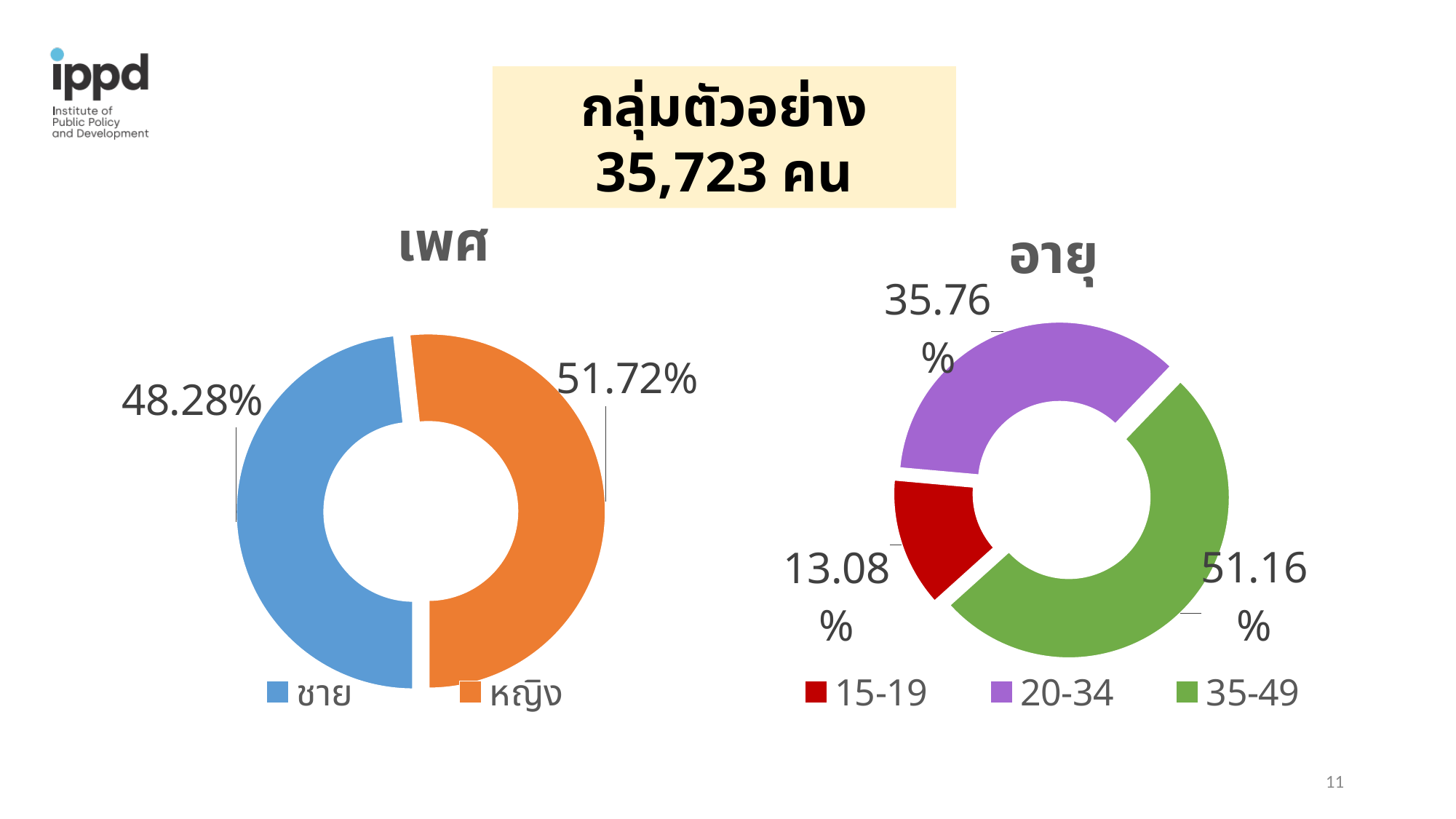
In the chart titled "เพศ", what percentage is shown for หญิง? 51.72% In the chart titled "เพศ", which category has the larger share? หญิง In the chart titled "อายุ", which is larger: the share for 20-34 or the share for 35-49? 35-49 In the chart titled "อายุ", what percentage is shown for the 15-19 group? 13.08% In the chart titled "อายุ", which age group has the largest share? 35-49 How many age groups does the legend of the chart titled "อายุ" list? 3 In the chart titled "อายุ", which age group has the smallest share? 15-19 In the chart titled "เพศ", what is the difference in percentage points between หญิง and ชาย? 3.44 In the chart titled "อายุ", what is the difference in percentage points between the 35-49 group and the 15-19 group? 38.08 In the chart titled "อายุ", what percentage is shown for the 20-34 group? 35.76% In the chart titled "เพศ", what percentage is shown for ชาย? 48.28% What kind of chart is the chart titled "เพศ"? Doughnut (pie) chart